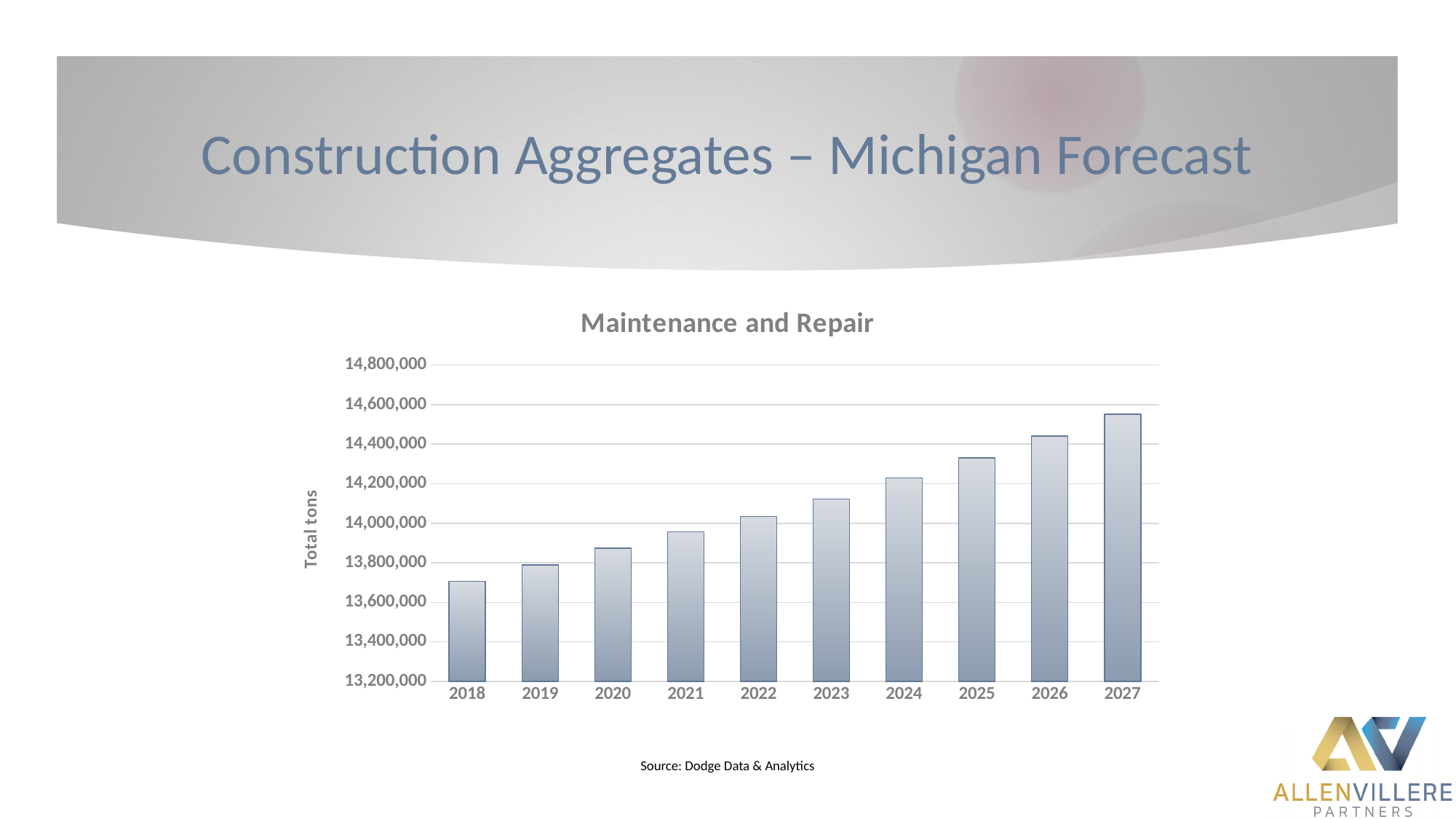
Do the values rise or fall from 2018 to 2027? rise Is the value for 2021 greater or less than 14,000,000? less What is the title of the chart? Maintenance and Repair Is the value for 2023 greater or less than 14,000,000? greater How many years are shown on the x axis of the chart? 10 Which year has the lowest value in the chart? 2018 What is the label on the vertical axis of the chart? Total tons Which year has the highest value in the chart? 2027 Which year has the larger value, 2020 or 2025? 2025 What kind of chart is shown on the slide? bar chart Is the value for 2027 greater or less than 14,400,000? greater